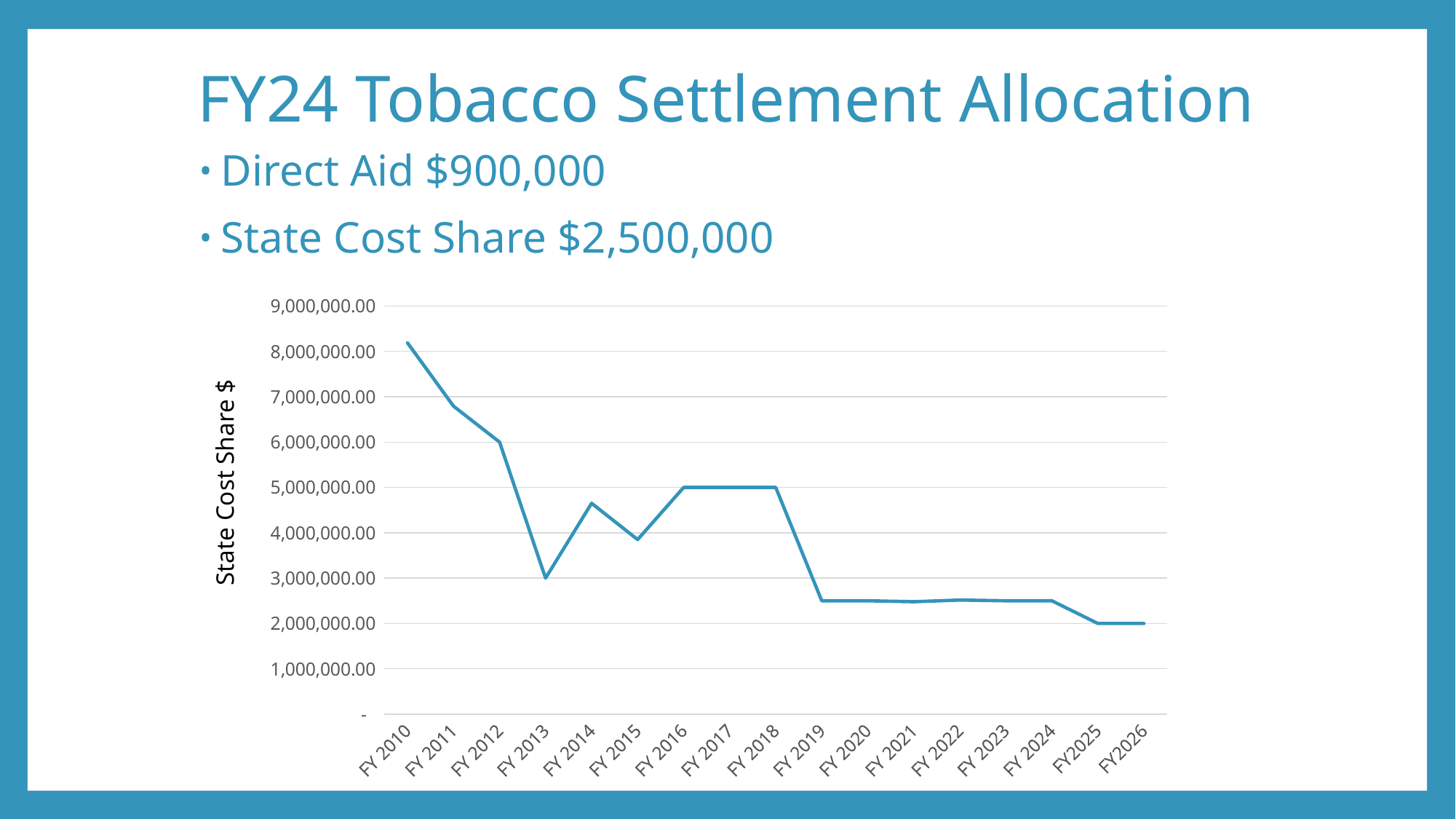
Is the State Cost Share value for FY 2015 greater or less than 4,000,000.00? less Overall, do the State Cost Share values rise or fall from FY 2010 to FY2026? fall Which fiscal year has the highest State Cost Share value in the chart? FY 2010 Is the State Cost Share value for FY 2010 greater or less than 8,000,000.00? greater Is the State Cost Share value for FY 2014 greater or less than 4,000,000.00? greater How many fiscal years are plotted along the x axis of the chart? 17 Which has the larger State Cost Share value, FY 2013 or FY 2016? FY 2016 What is the label on the vertical axis of the chart? State Cost Share $ Which has the larger State Cost Share value, FY 2012 or FY 2018? FY 2012 What kind of chart is shown on the slide? line chart